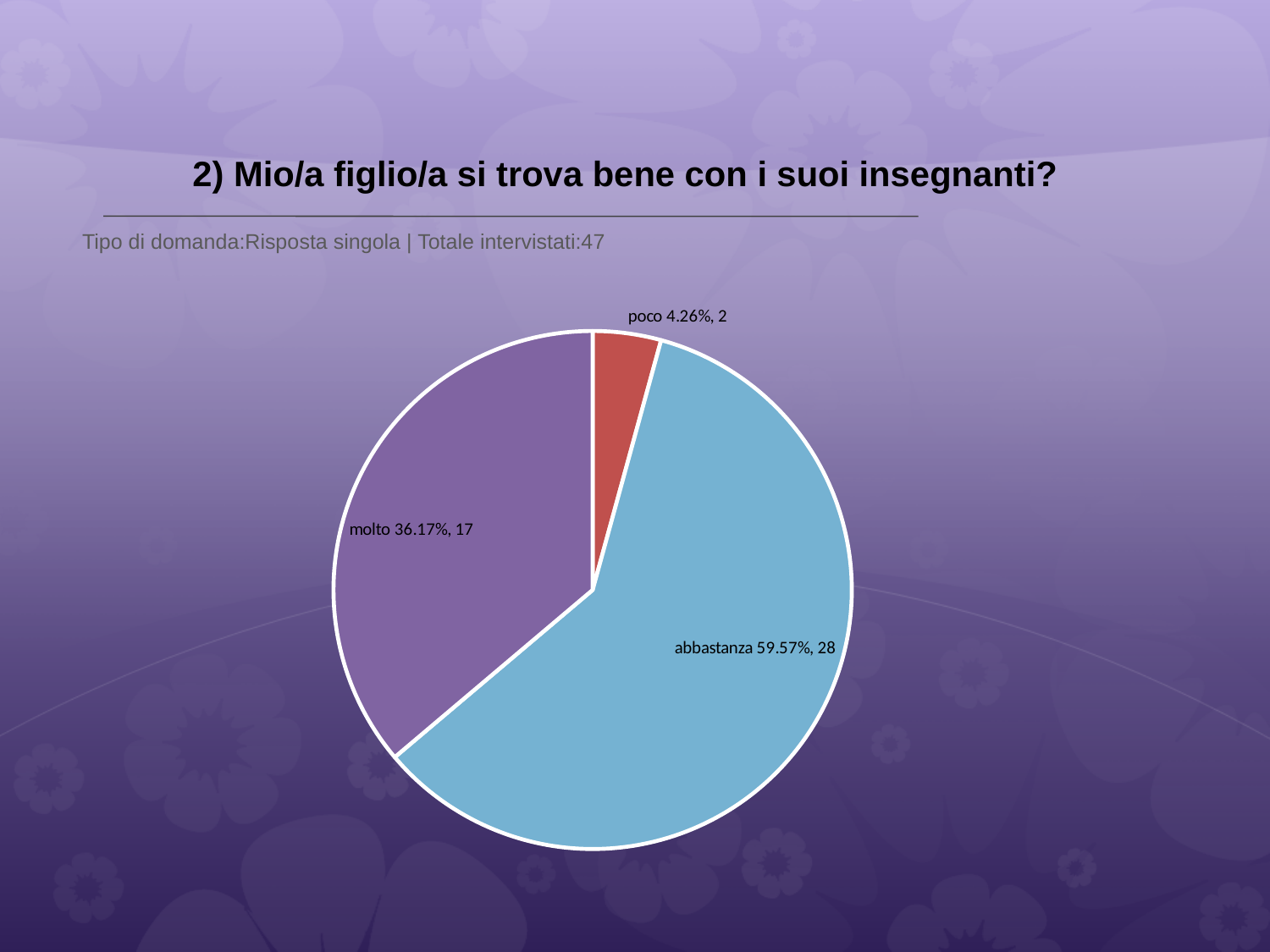
Which category has the largest slice of the pie? abbastanza What kind of chart is shown on the slide? pie chart Which is larger, the 'molto' slice or the 'poco' slice? molto What percentage share does the 'poco' slice have? 4.26% How many respondents answered 'molto'? 17 How many slices does the pie chart have? 3 How many respondents answered 'poco'? 2 How many respondents answered 'abbastanza'? 28 Which category has the smallest slice of the pie? poco What percentage share does the 'molto' slice have? 36.17% What percentage share does the 'abbastanza' slice have? 59.57% What is the difference in respondent count between 'abbastanza' and 'molto'? 11